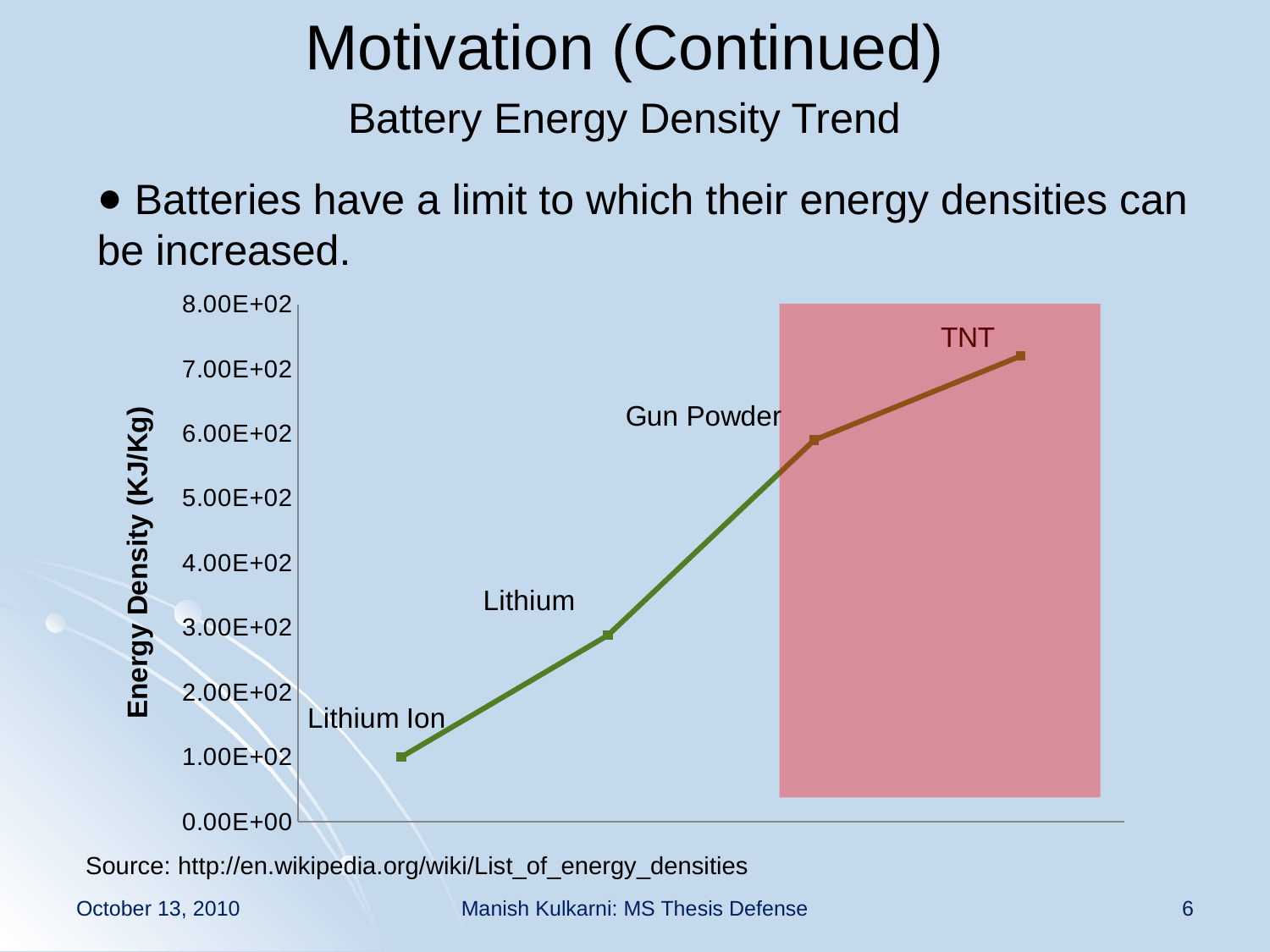
What kind of chart is shown on the slide? line chart Is the energy density of Lithium Ion greater or less than 2.00E+02? less Is the energy density of TNT greater or less than 7.00E+02? greater How many data points are plotted on the line? 4 Which material has the highest energy density on the chart? TNT What is the label of the y axis? Energy Density (KJ/Kg) Which material has the lowest energy density on the chart? Lithium Ion Which two materials fall inside the shaded red region of the chart? Gun Powder and TNT Which has a higher energy density, Gun Powder or Lithium? Gun Powder Is the energy density of Gun Powder greater or less than 5.00E+02? greater Do the values rise or fall moving from Lithium Ion to TNT along the x axis? rise